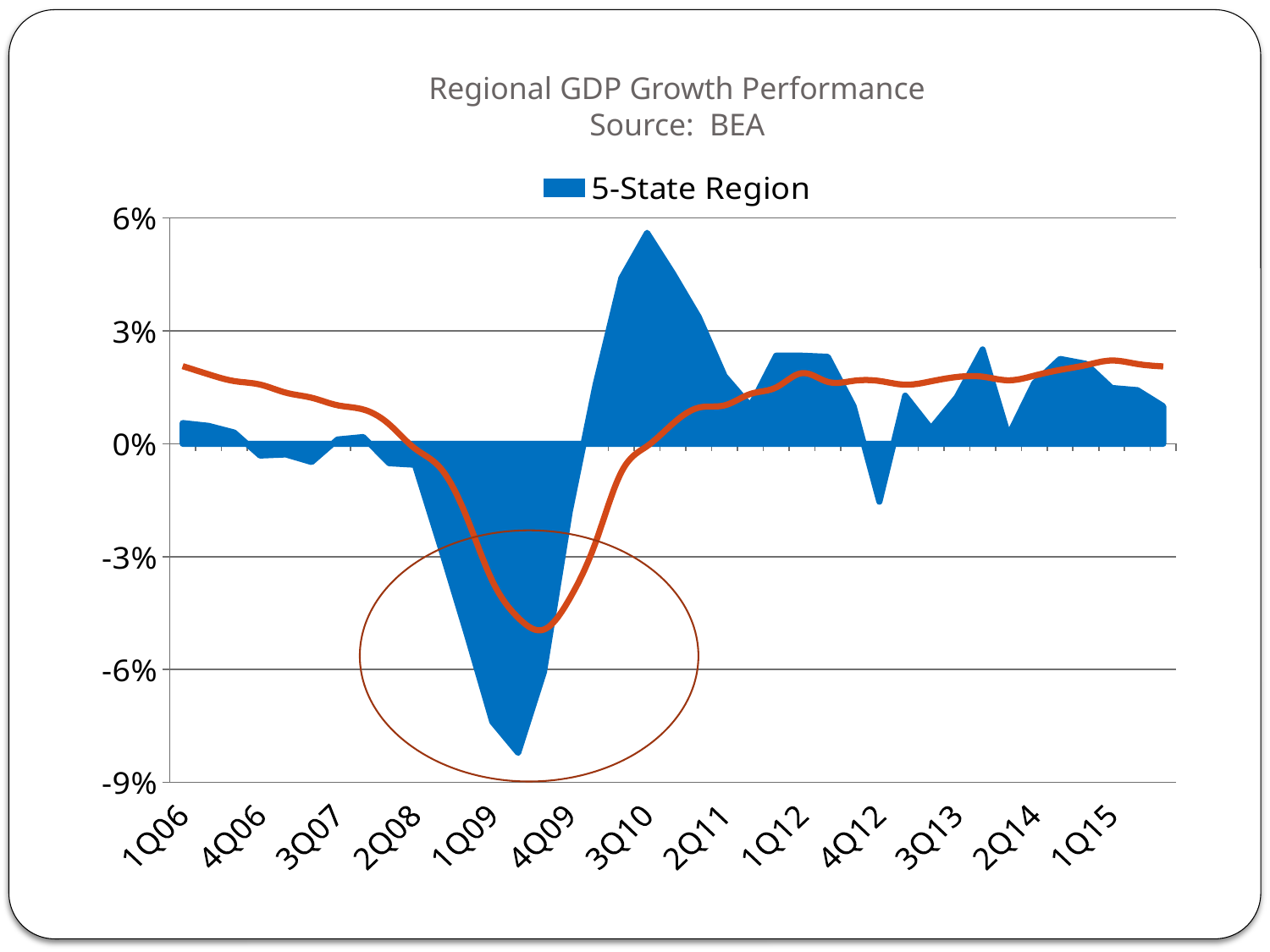
Is the value for 4Q12 greater or less than 0%? less What is the name of the series shown in the legend? 5-State Region Is the value for 1Q12 greater or less than 0%? greater What is the title of the chart? Regional GDP Growth Performance Source: BEA What kind of chart is shown on the slide? combination area and line chart Between 4Q09 and 3Q10, do the values rise or fall? rise Which is larger, the value for 3Q10 or the value for 1Q09? 3Q10 How many category labels are shown on the x axis? 13 Is the value for 1Q09 greater or less than -6%? less How many series does the legend list? 1